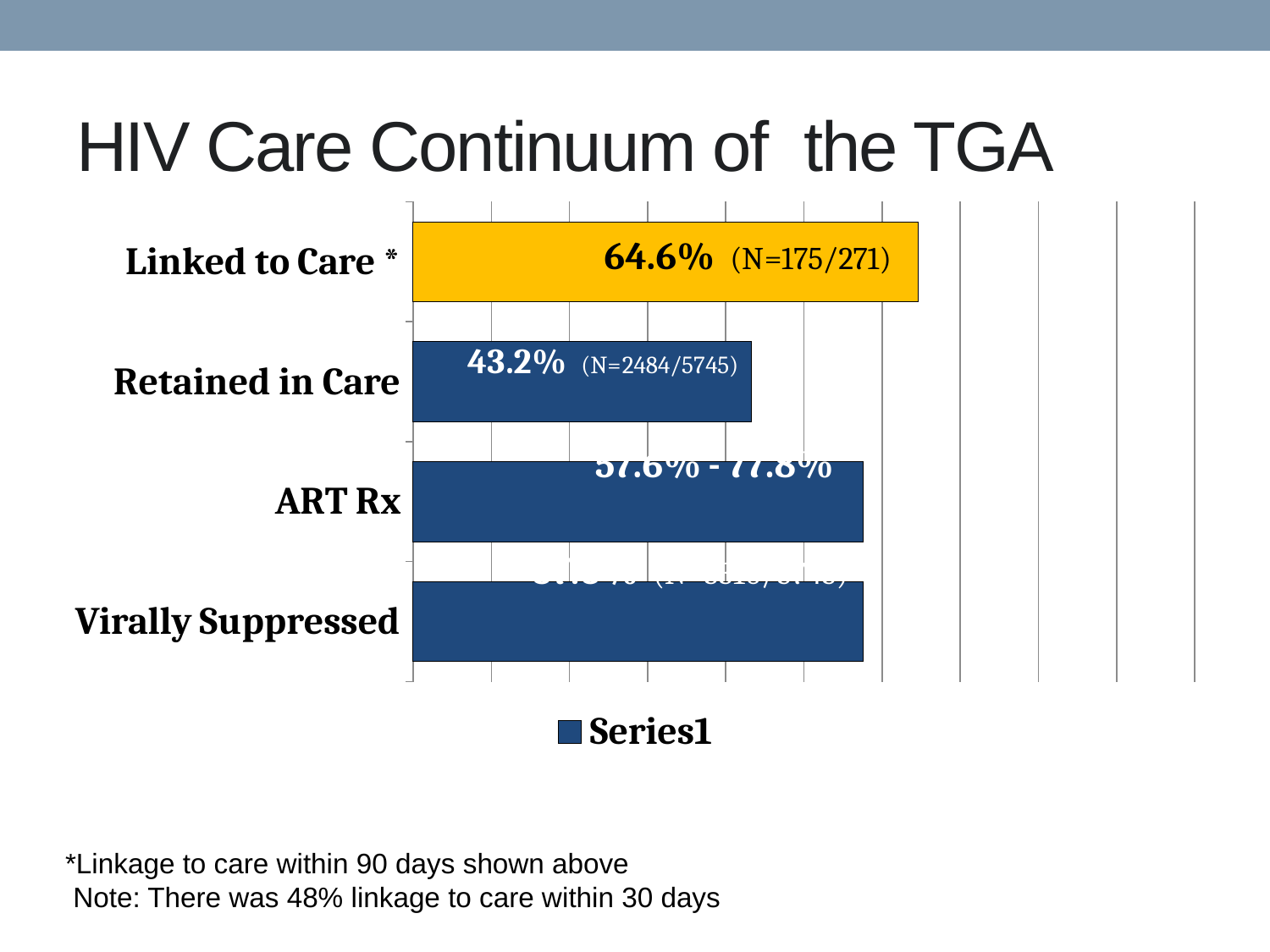
Which category has the lowest value? Retained in Care What kind of chart is shown? Bar chart Which is larger, the value for Linked to Care or for Retained in Care? Linked to Care What N is shown for Linked to Care? N=175/271 What is the difference between the Linked to Care value and the Retained in Care value? 21.4 percentage points What is the value for Retained in Care? 43.2% Which category has the highest value? Linked to Care How many series does the legend list? 1 What N is shown for Retained in Care? N=2484/5745 How many categories are shown in the chart? 4 What is the title of the slide? HIV Care Continuum of the TGA What is the value for Linked to Care? 64.6%